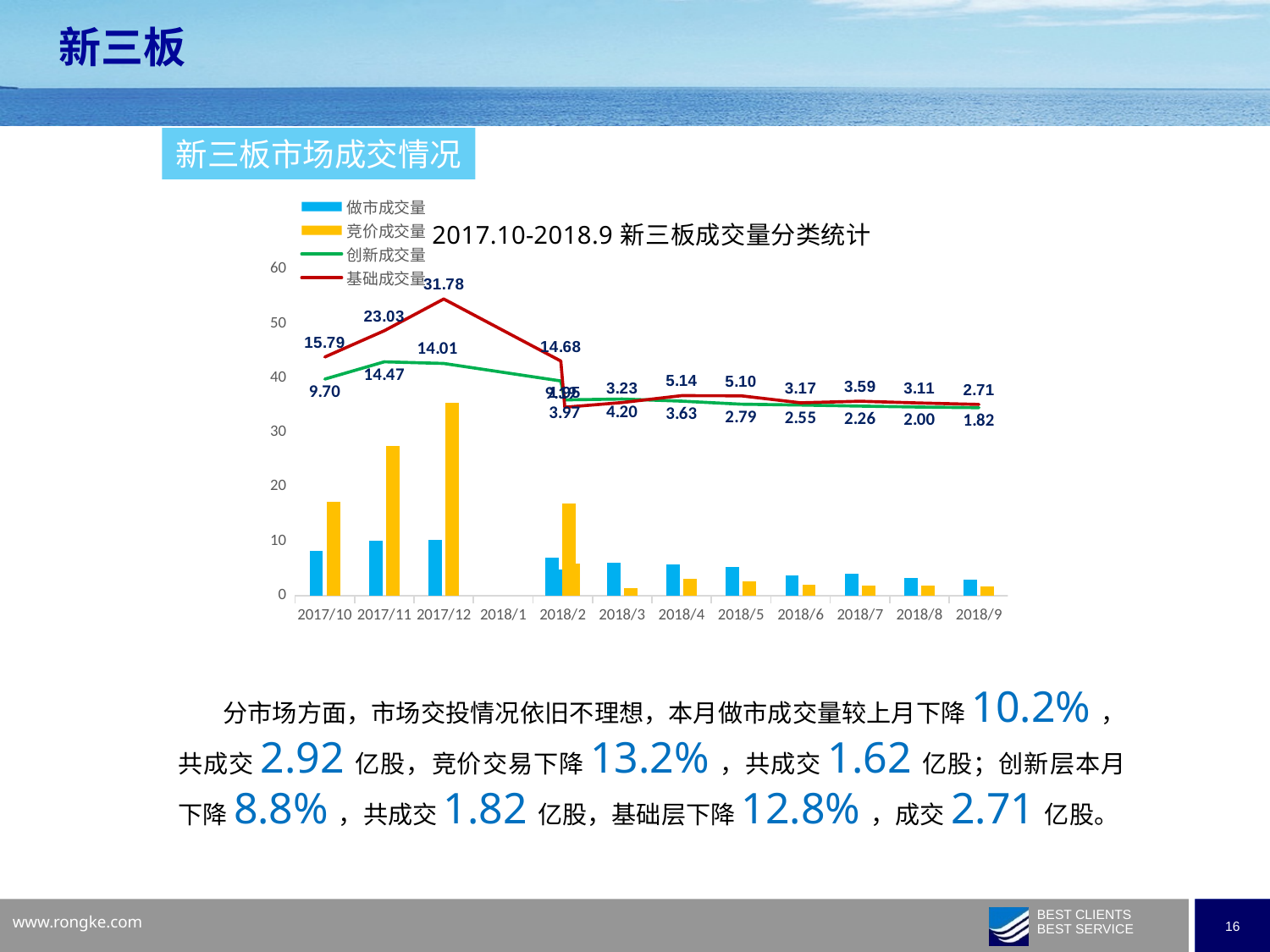
Does 创新成交量 rise or fall from 2018/3 to 2018/9? fall How many series does the chart legend list? 4 How many months are shown along the x axis of the chart? 12 In 2018/4, which is larger: 基础成交量 or 创新成交量? 基础成交量 In which month is 创新成交量 lowest? 2018/9 What kind of chart is shown on the slide? A combined bar and line chart What is the value of 创新成交量 for 2018/9? 1.82 What is the title of the chart? 2017.10-2018.9 新三板成交量分类统计 In which month is 基础成交量 highest? 2017/12 What is the value of 基础成交量 for 2017/12? 31.78 What is the difference between 基础成交量 in 2017/12 and in 2017/11? 8.75 Is the 竞价成交量 bar for 2017/12 greater or less than 30? greater